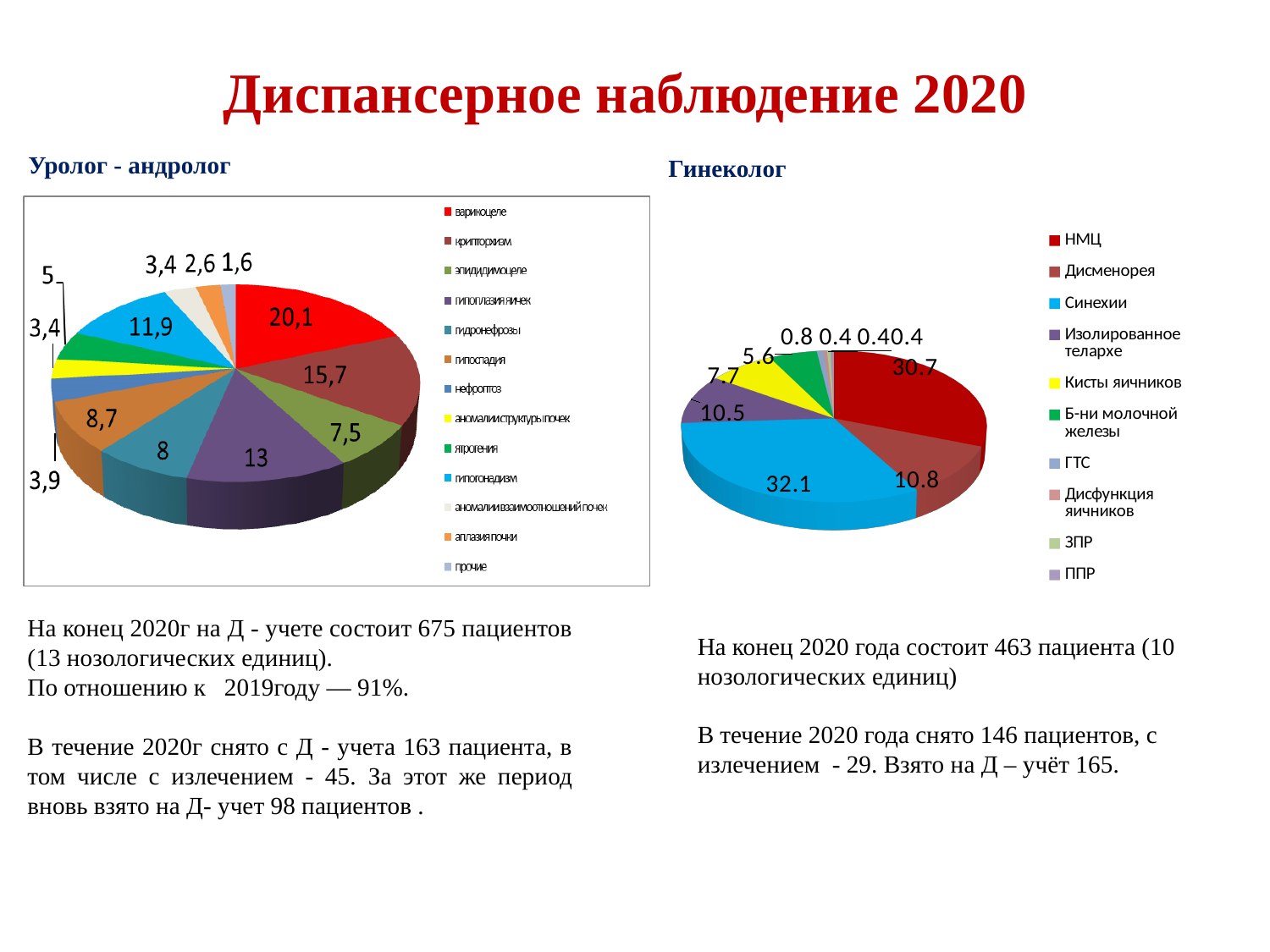
In the Гинеколог chart, which category has the largest share? Синехии What type of chart is the Гинеколог chart? Pie chart In the Гинеколог chart, what is the difference between the values for Синехии and НМЦ? 1.4 How many categories does the legend of the Уролог - андролог chart list? 13 In the Уролог - андролог chart, what is the difference between the two largest slices, 20,1 and 15,7? 4,4 In the Уролог - андролог chart, which category has the largest share? варикоцеле How many categories does the legend of the Гинеколог chart list? 10 In the Уролог - андролог chart, what is the value for варикоцеле? 20,1 In the Гинеколог chart, what is the value for Кисты яичников? 7.7 In the Гинеколог chart, what is the value for Синехии? 32.1 In the Гинеколог chart, which is larger: Дисменорея or Изолированное телархе? Дисменорея In the Гинеколог chart, what is the value for НМЦ? 30.7